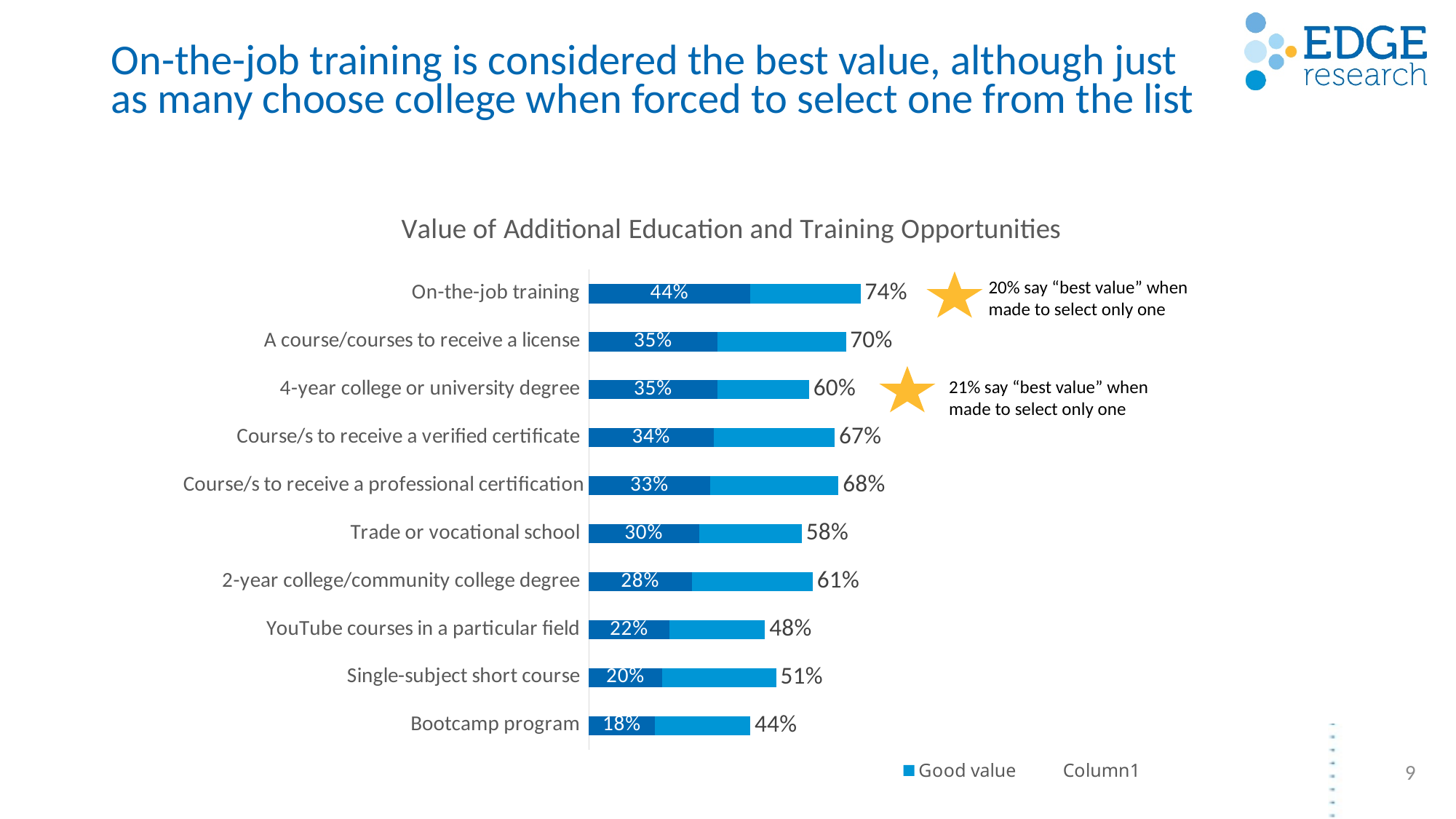
What value is printed inside the dark blue segment for On-the-job training? 44% How many series does the legend list? 2 Which category has the highest value printed at the end of its bar? On-the-job training What value is printed at the end of the bar for A course/courses to receive a license? 70% What is the title of the chart? Value of Additional Education and Training Opportunities How many categories are plotted in the chart? 10 What value is printed at the end of the bar for 4-year college or university degree? 60% Which has the larger value printed at the end of its bar: Trade or vocational school or 2-year college/community college degree? 2-year college/community college degree What kind of chart is shown on the slide? Stacked horizontal bar chart What value is printed inside the dark blue segment for Bootcamp program? 18% What is the difference between the dark blue segment values for On-the-job training and Bootcamp program? 26 percentage points Which category has the lowest value printed inside its dark blue segment? Bootcamp program